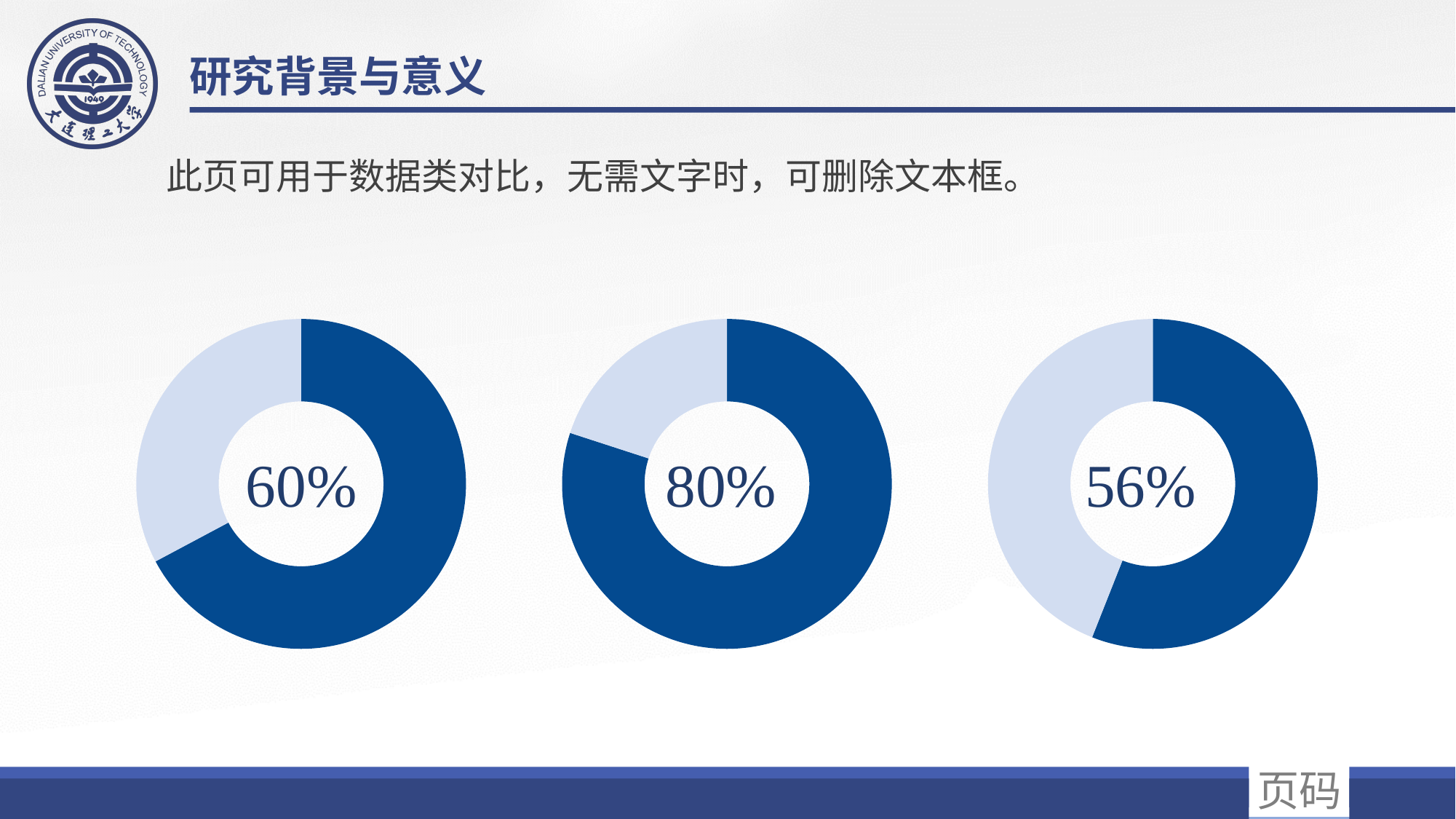
Which of the three donut charts shows the lowest percentage? The right chart (56%) What percentage is shown in the centre of the right donut chart? 56% What is the title of the slide containing the donut charts? 研究背景与意义 Which of the three donut charts shows the highest percentage? The middle chart (80%) What kind of chart is used on this slide? Donut (pie) chart How many donut charts are on the slide? 3 Is the percentage in the left donut chart larger or smaller than the percentage in the right donut chart? Larger What percentage is shown in the centre of the middle donut chart? 80% In the middle donut chart, what share of the ring is filled with the dark blue colour? 80% What percentage is shown in the centre of the left donut chart? 60% What is the difference between the percentage in the middle donut chart and the percentage in the left donut chart? 20% What is the difference between the percentage in the left donut chart and the percentage in the right donut chart? 4%